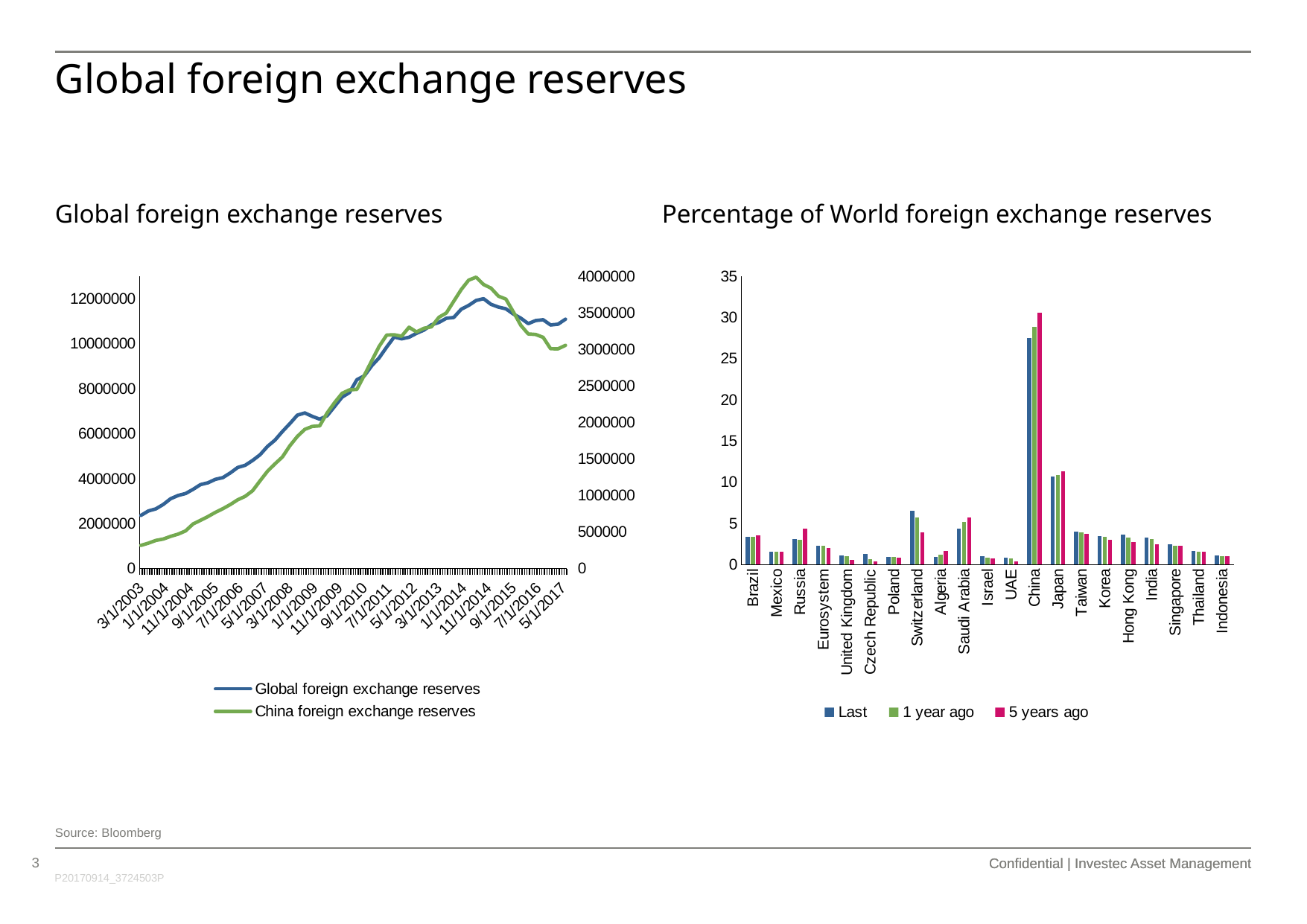
How many series does the legend of the 'Percentage of World foreign exchange reserves' chart list? 3 How many countries or regions are shown on the x axis of the 'Percentage of World foreign exchange reserves' chart? 21 What kind of chart is the 'Percentage of World foreign exchange reserves' chart on the right? bar chart In the 'Percentage of World foreign exchange reserves' chart, is the 'Last' value for Switzerland greater or less than 5? greater In the 'Percentage of World foreign exchange reserves' chart, is the 'Last' value for China greater or less than 25? greater In the 'Percentage of World foreign exchange reserves' chart, which is larger for Russia: the 'Last' value or the '5 years ago' value? 5 years ago In the 'Percentage of World foreign exchange reserves' chart, which country has the highest 'Last' value? China What kind of chart is the 'Global foreign exchange reserves' chart on the left? line chart In the 'Global foreign exchange reserves' chart, do the global foreign exchange reserves generally rise or fall from 2003 to 2014? rise How many series does the legend of the 'Global foreign exchange reserves' chart list? 2 In the 'Global foreign exchange reserves' chart, is the peak value of China foreign exchange reserves (right axis) greater or less than 3500000? greater